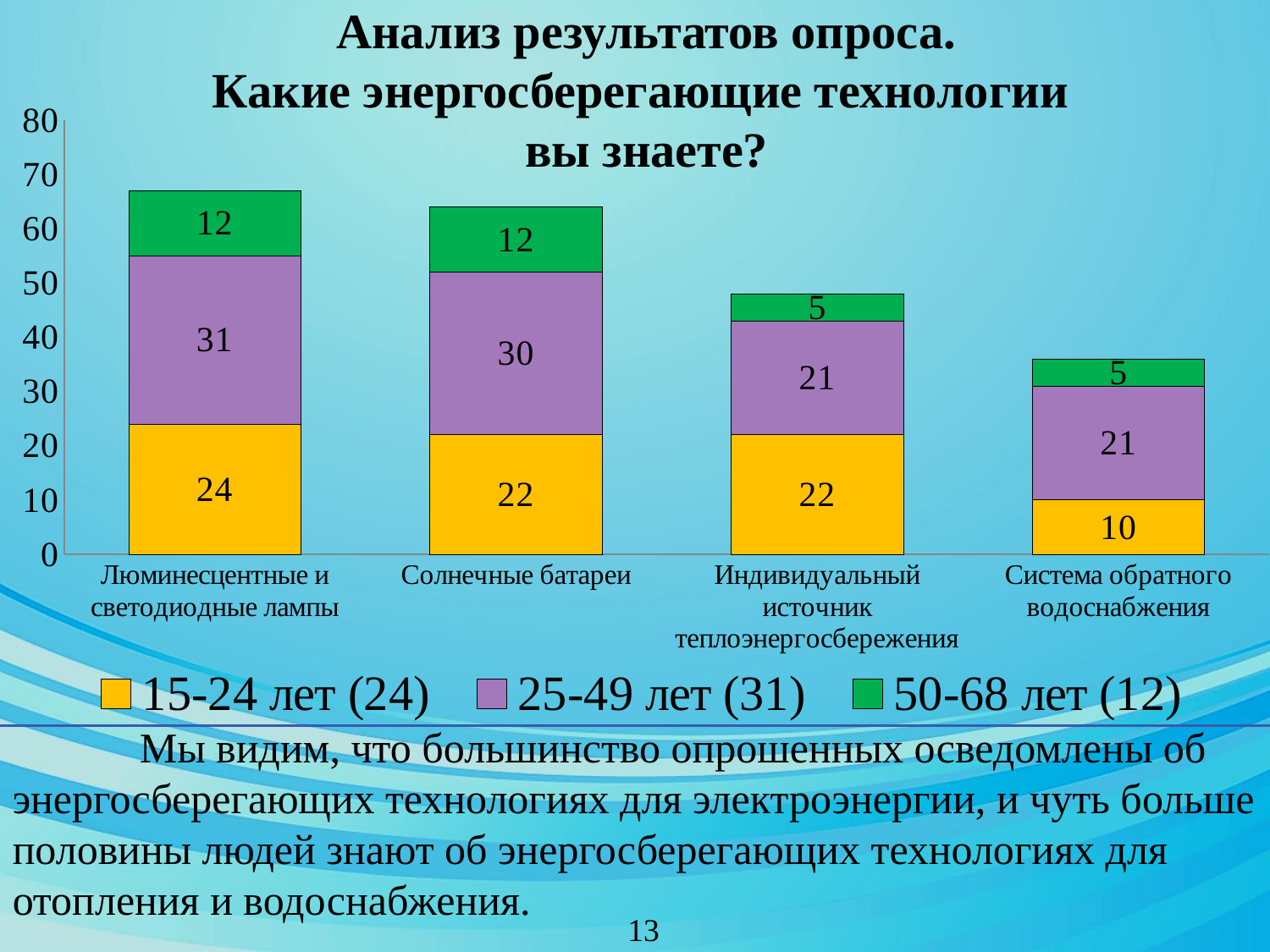
What type of chart is shown on the slide? Stacked bar chart What is the difference between the 15-24 лет values for Люминесцентные и светодиодные лампы and Система обратного водоснабжения? 14 Which is larger: the 25-49 лет value for Люминесцентные и светодиодные лампы or for Индивидуальный источник теплоэнергосбережения? Люминесцентные и светодиодные лампы What is the total of the stacked bar for Люминесцентные и светодиодные лампы? 67 What is the value for the 50-68 лет series in the Система обратного водоснабжения category? 5 What is the total of the stacked bar for Система обратного водоснабжения? 36 How many series does the legend list? 3 What is the value for the 15-24 лет series in the Люминесцентные и светодиодные лампы category? 24 Which category has the lowest total stacked bar? Система обратного водоснабжения Which colour represents the 50-68 лет series in the legend? Green How many categories are shown on the x axis of the chart? 4 What is the value for the 25-49 лет series in the Солнечные батареи category? 30